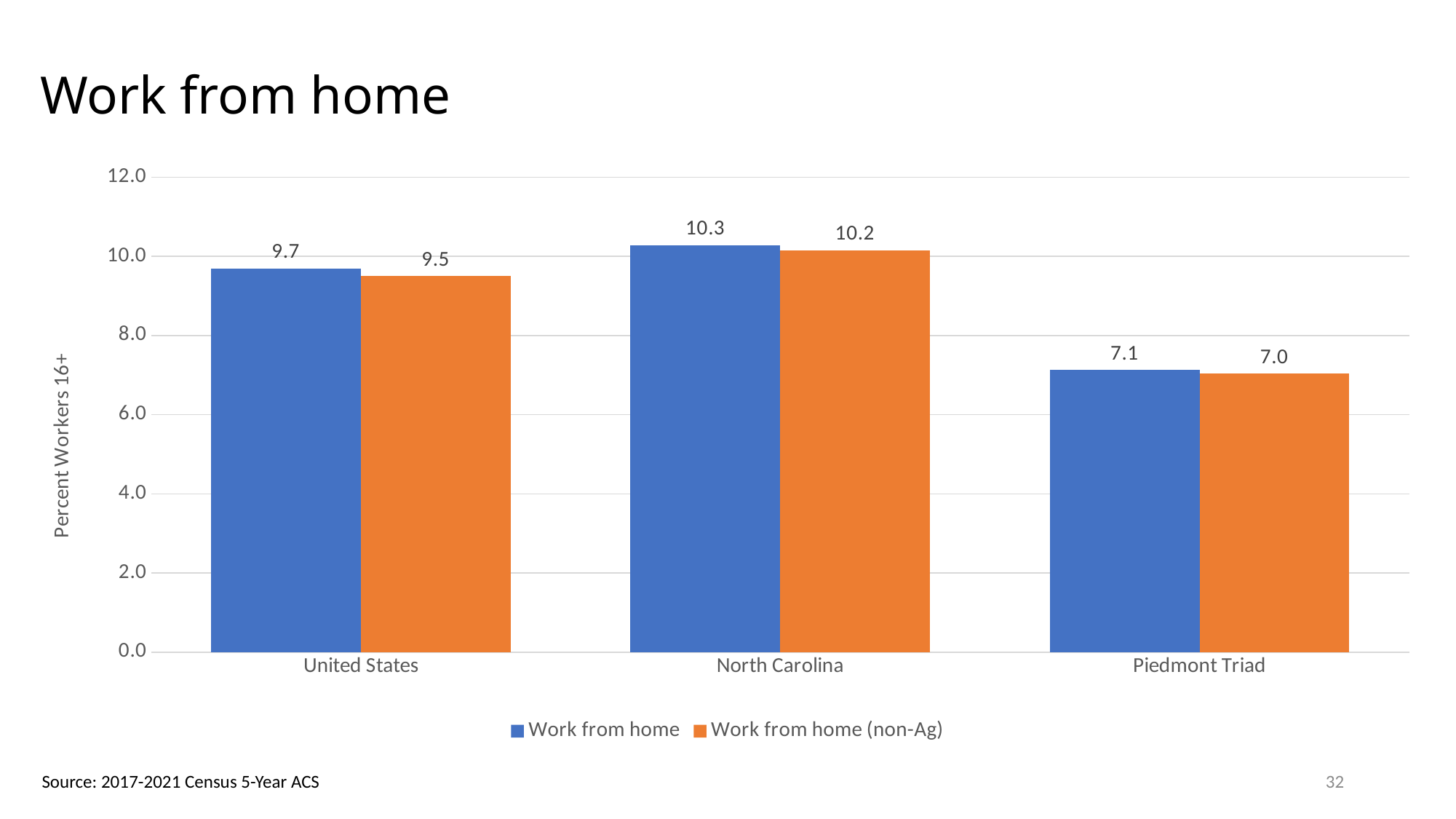
Is the Work from home (non-Ag) value for North Carolina greater or less than 8.0? greater What kind of chart is shown on the slide? bar chart Which is larger: the Work from home value for the United States or for Piedmont Triad? United States What is the Work from home (non-Ag) value for Piedmont Triad? 7.0 What is the Work from home value for North Carolina? 10.3 How many regions are shown on the x axis? 3 How many series does the legend list? 2 What is the Work from home value for the United States? 9.7 What is the label of the y axis? Percent Workers 16+ Which region has the highest Work from home value? North Carolina What is the difference between the Work from home values for North Carolina and Piedmont Triad? 3.2 Which region has the lowest Work from home (non-Ag) value? Piedmont Triad